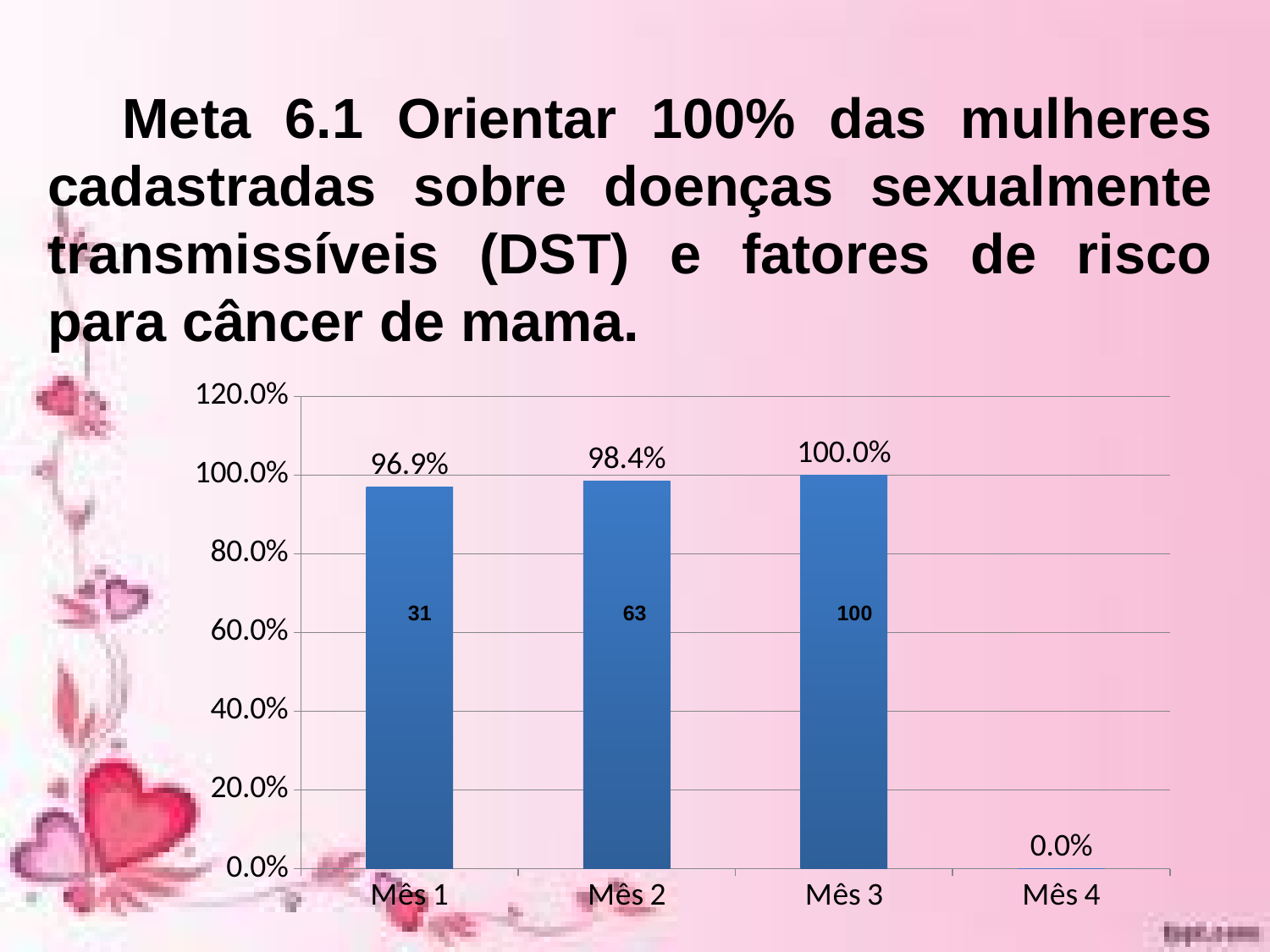
Which month has the lowest percentage value? Mês 4 How many months (categories) are shown on the x axis? 4 Which month has the highest percentage value? Mês 3 What is the percentage value shown for Mês 1? 96.9% Do the percentage values rise or fall from Mês 1 to Mês 3? Rise What is the difference in percentage points between Mês 3 and Mês 1? 3.1% What number is printed inside the bar for Mês 3? 100 What kind of chart is shown on the slide? Bar chart What number is printed inside the bar for Mês 1? 31 What is the percentage value shown for Mês 4? 0.0% Which is larger, the percentage for Mês 2 or for Mês 1? Mês 2 What is the percentage value shown for Mês 2? 98.4%